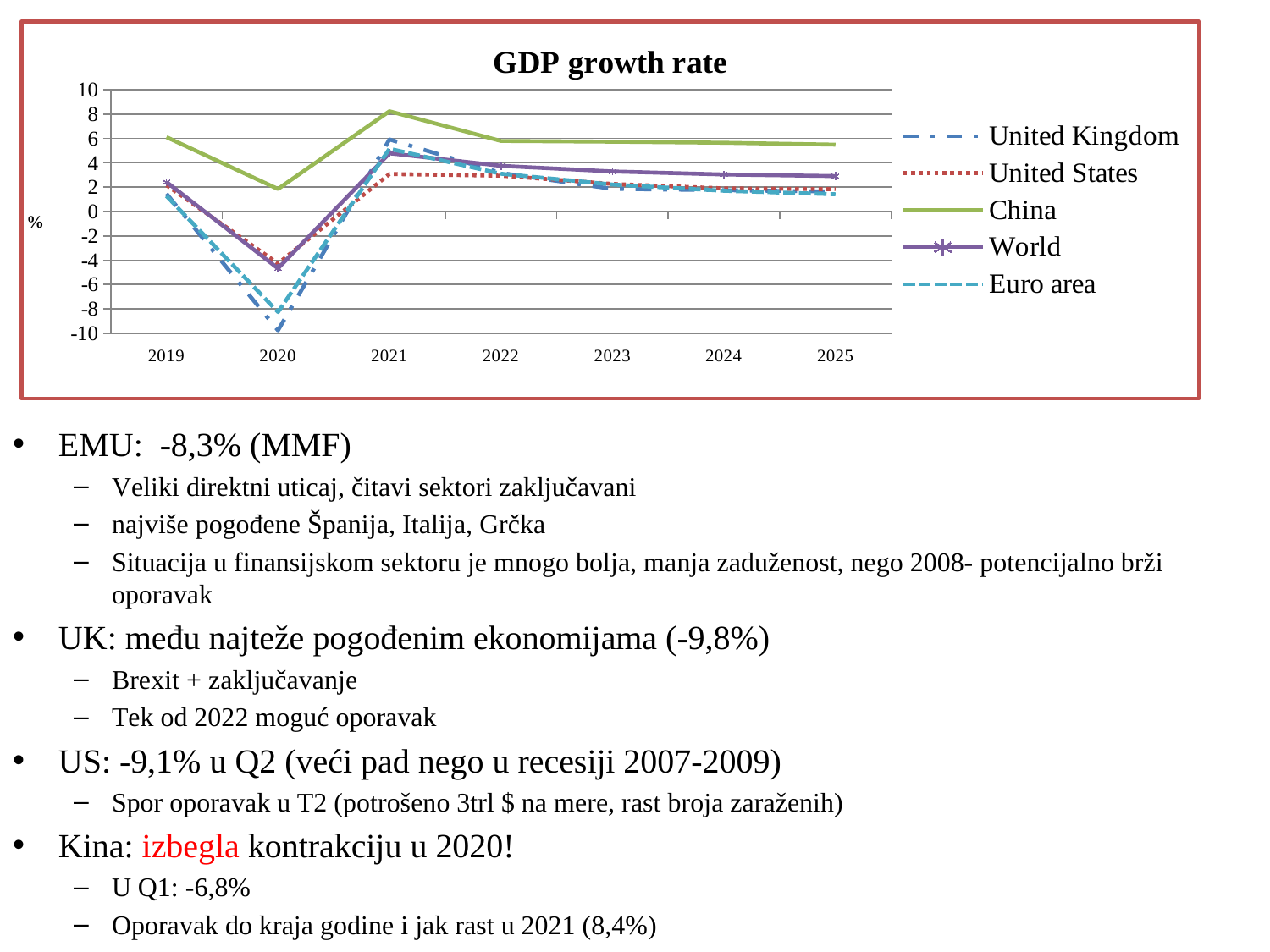
How many series does the chart legend list? 5 Is the value for China in 2021 greater or less than 6? greater In 2020, which is larger: the value for the United States or the value for the Euro area? United States Does the China series rise or fall from 2021 to 2025? fall What is the title of the chart? GDP growth rate Is the value for the United Kingdom in 2020 greater or less than -8? less Is the value for the United States in 2020 greater or less than -2? less Which series has the lowest GDP growth rate in 2020? United Kingdom What kind of chart is shown on the slide? line chart Which series has the highest GDP growth rate in 2021? China Which series has the highest GDP growth rate in 2020? China How many years are shown on the x axis of the chart? 7